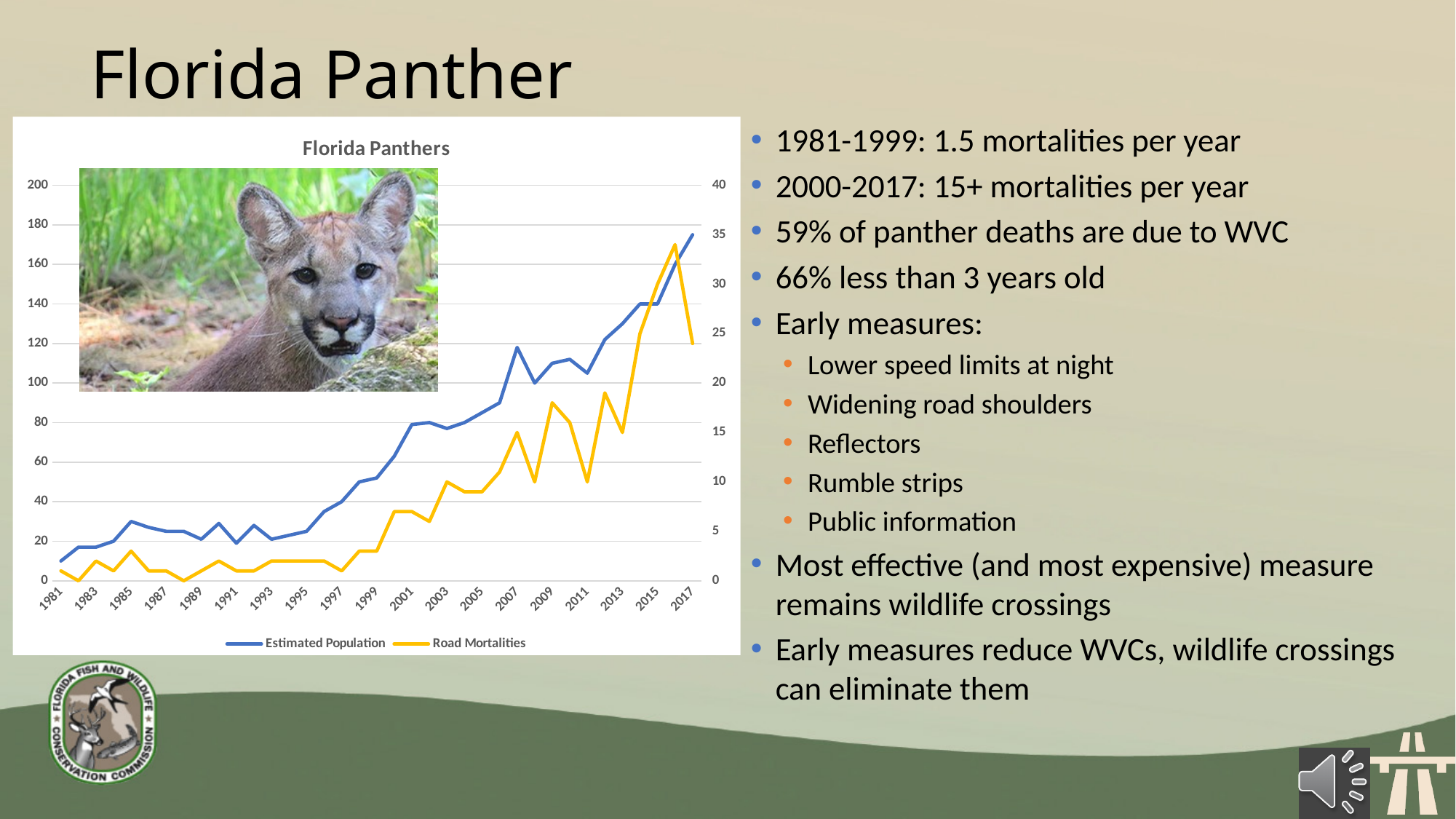
Is the Estimated Population value for 2007 greater or less than 100? greater Is the Road Mortalities value for 1989 greater or less than 5? less What is the title of the chart? Florida Panthers How many series does the chart's legend list? 2 Which series is drawn in yellow? Road Mortalities Is the Road Mortalities value for 2017 greater or less than 30? less What type of chart is shown on the slide? Line chart Does the Estimated Population series generally rise or fall from 1981 to 2017? Rise Which year has the highest Estimated Population? 2017 Is the Estimated Population larger in 1981 or in 2017? 2017